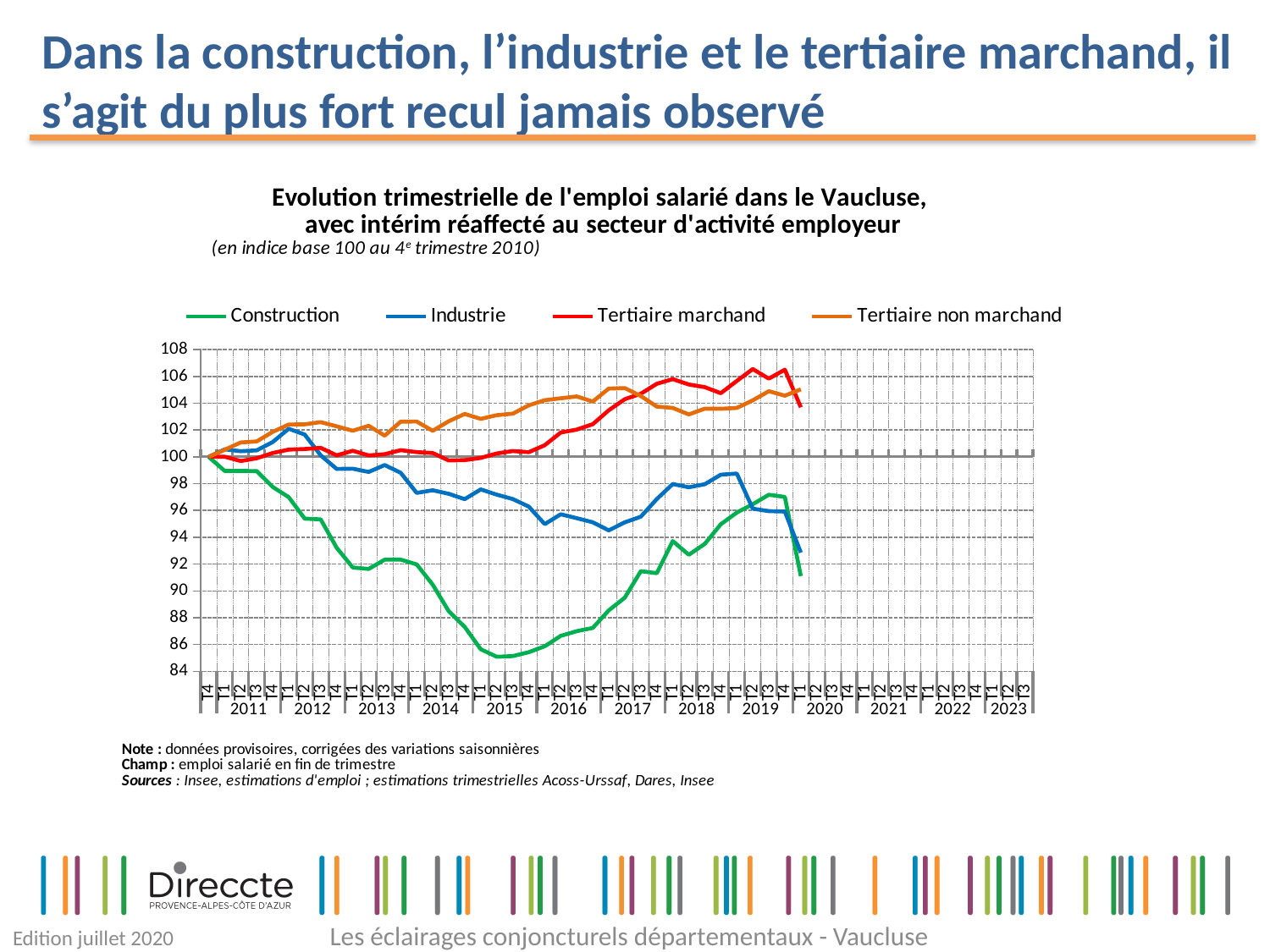
What is the index value of all four series at T4 2010, the base quarter? 100 Is the value for Construction in T1 2015 greater or less than 88? less In T1 2020, which is larger: the value for Industrie or the value for Construction? Industrie Is the value for Tertiaire marchand in T2 2019 greater or less than 104? greater Does the Construction series rise or fall between T4 2010 and T1 2015? fall Which series are listed in the legend? Construction, Industrie, Tertiaire marchand, Tertiaire non marchand Is the value for Industrie in T1 2020 greater or less than 96? less Which series has the highest value in T1 2020? Tertiaire non marchand Which series has the lowest value in T1 2020? Construction What type of chart is shown on the slide? line chart How many series does the legend list? 4